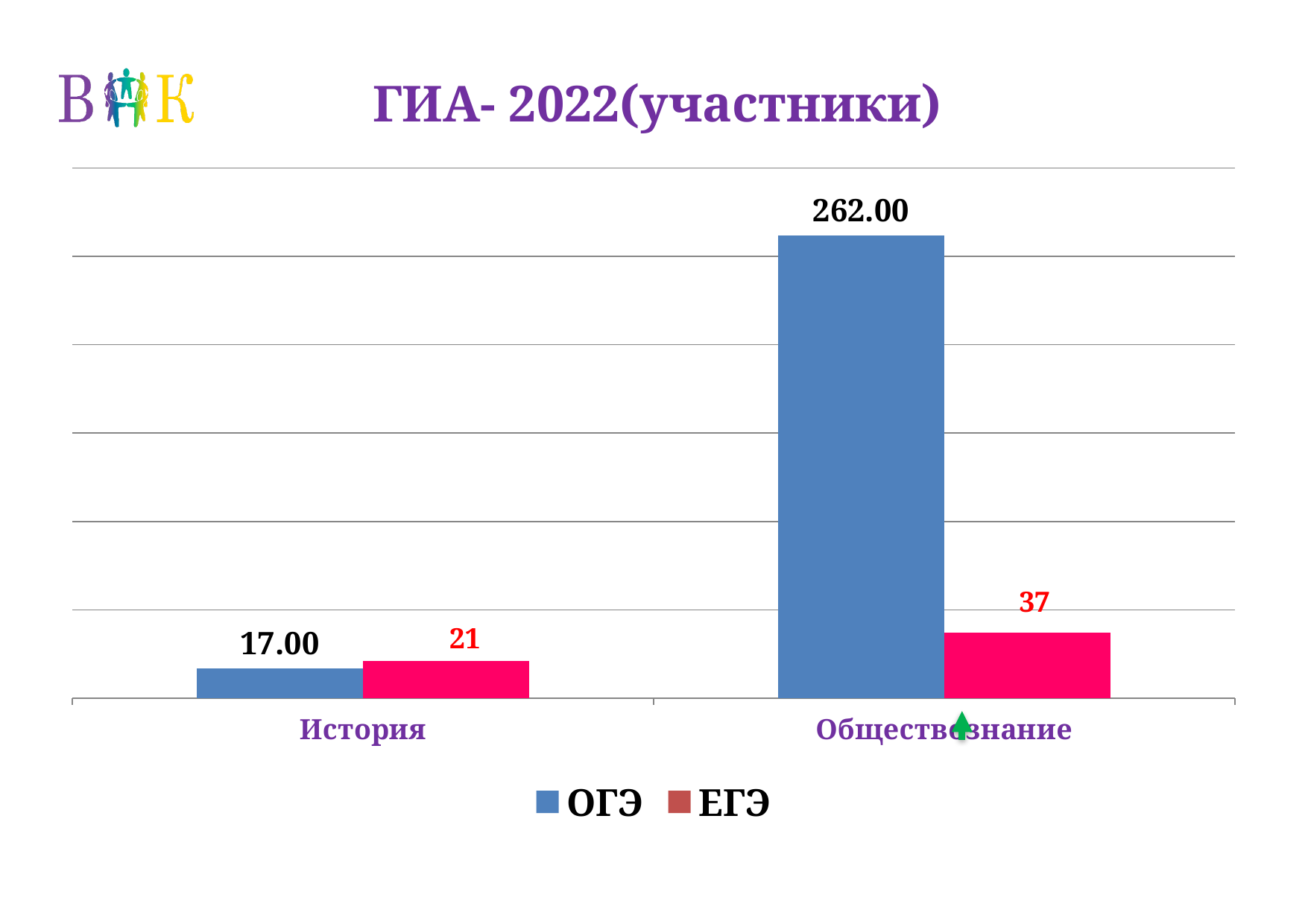
What is the difference between the ОГЭ and ЕГЭ values for Обществознание? 225 What is the ЕГЭ value for История? 21 What is the title of the chart? ГИА- 2022(участники) How many series does the legend list? 2 What is the ОГЭ value for Обществознание? 262.00 Which category has the highest ОГЭ value? Обществознание How many categories are shown on the x axis? 2 Which is larger for История: the ОГЭ value or the ЕГЭ value? ЕГЭ What is the ЕГЭ value for Обществознание? 37 Which category has the lowest ЕГЭ value? История What is the ОГЭ value for История? 17.00 What kind of chart is shown on the slide? Bar chart